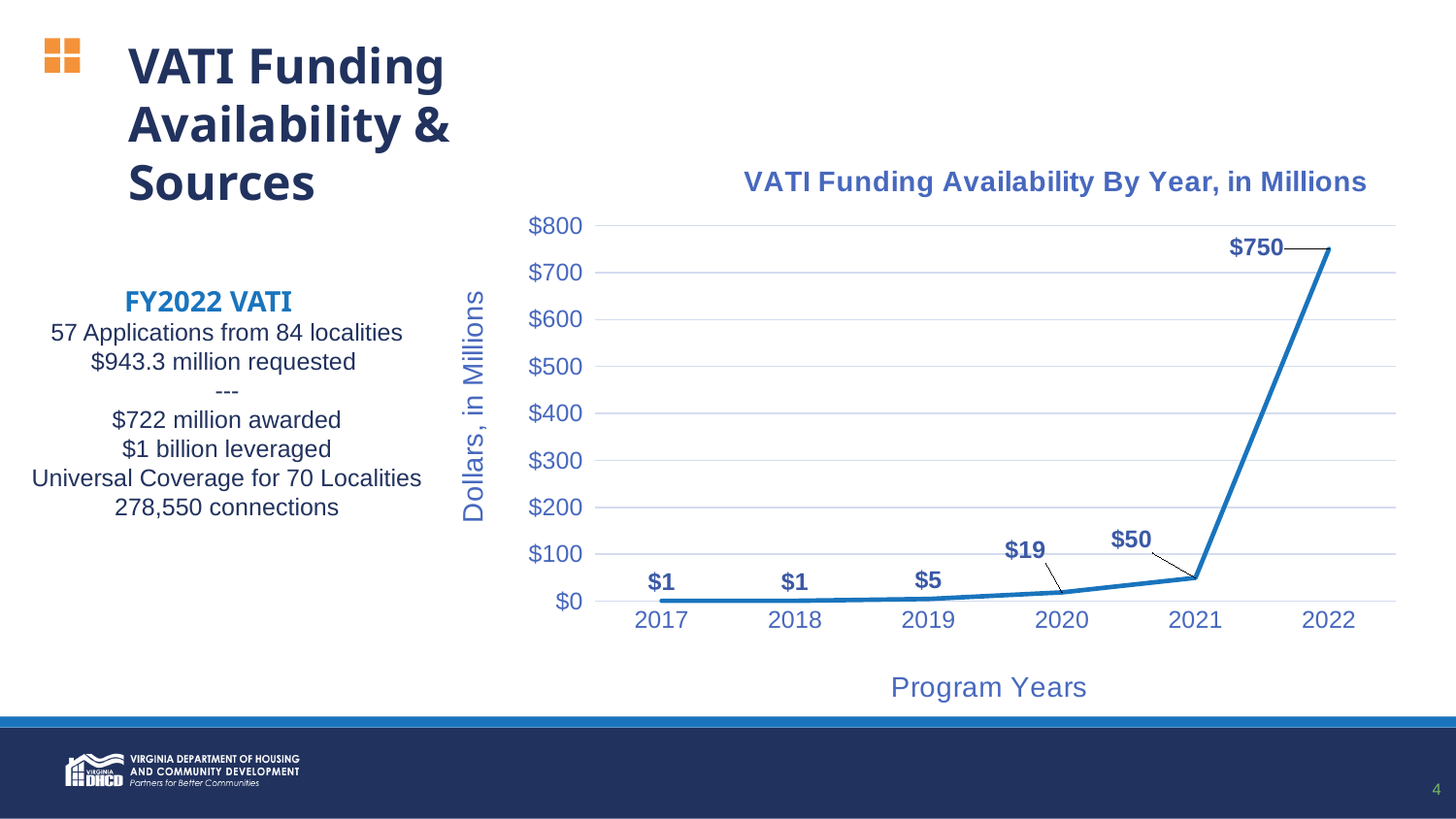
What is the VATI funding availability for 2019? $5 Which year has greater funding availability, 2019 or 2020? 2020 What kind of chart is shown on the slide? Line chart Which program year has the highest funding availability? 2022 Do the funding values rise or fall from 2017 to 2022? Rise What is the VATI funding availability for 2020? $19 What is the VATI funding availability for 2021? $50 What is the VATI funding availability for 2022? $750 How many program years are plotted on the chart? 6 What is the difference in funding availability between 2022 and 2021? $700 What is the title of the chart? VATI Funding Availability By Year, in Millions What is the difference in funding availability between 2021 and 2020? $31